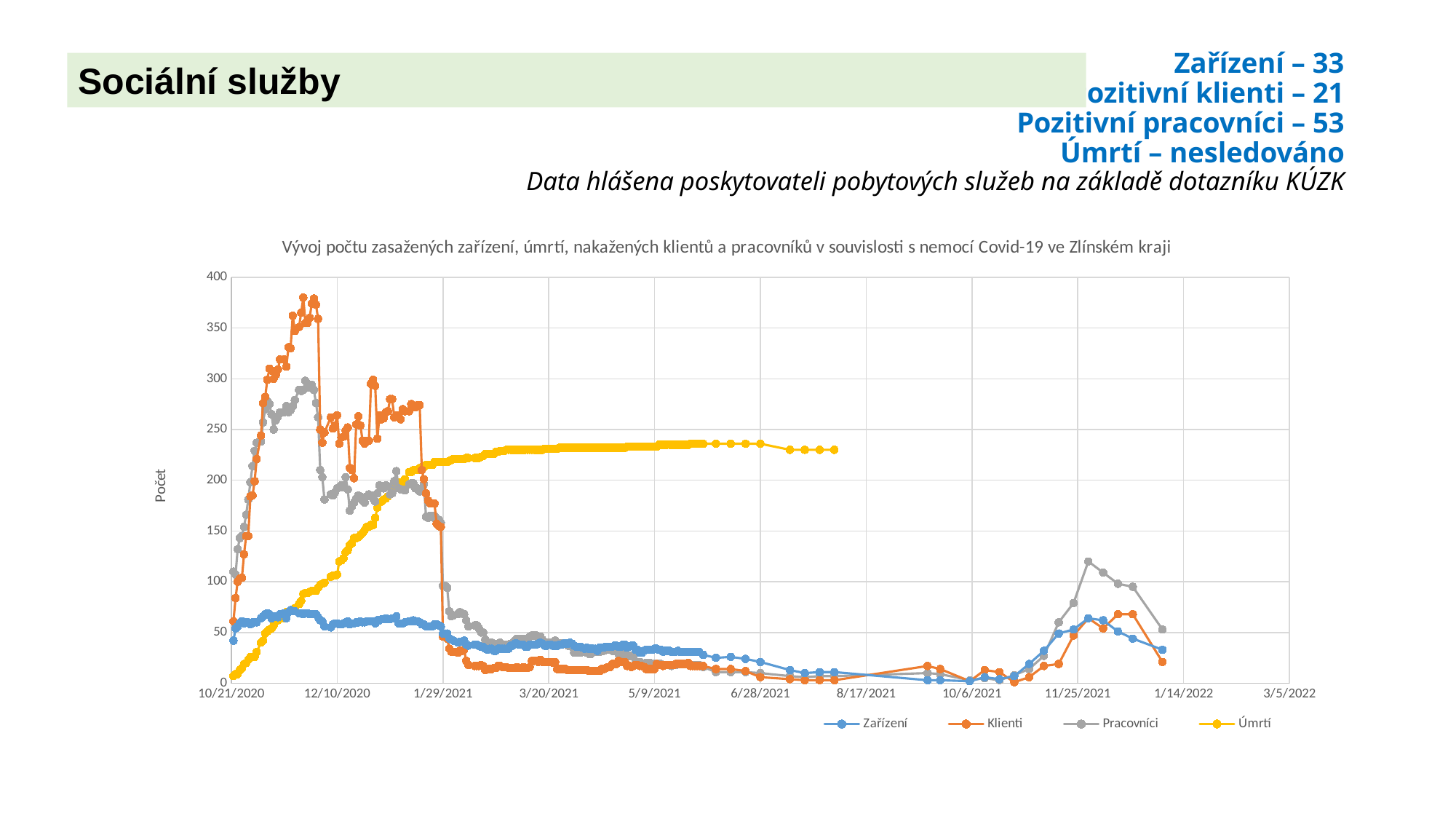
Which series reaches the highest peak value in the chart? Klienti Does the Úmrtí series rise or fall over the period it is plotted? rise Does the Zařízení series rise or fall between 12/10/2020 and 10/6/2021? fall What is the label on the vertical axis of the chart? Počet Is the peak of the Pracovníci series around 11/25/2021 greater or less than 100? greater Is the last plotted value of the Úmrtí series greater or less than 200? greater Which series is drawn in yellow in the chart? Úmrtí Which series has the larger value around 6/28/2021, Úmrtí or Zařízení? Úmrtí Is the peak value of the Klienti series greater or less than 350? greater How many series does the chart legend list? 4 What kind of chart is shown on the slide? line chart